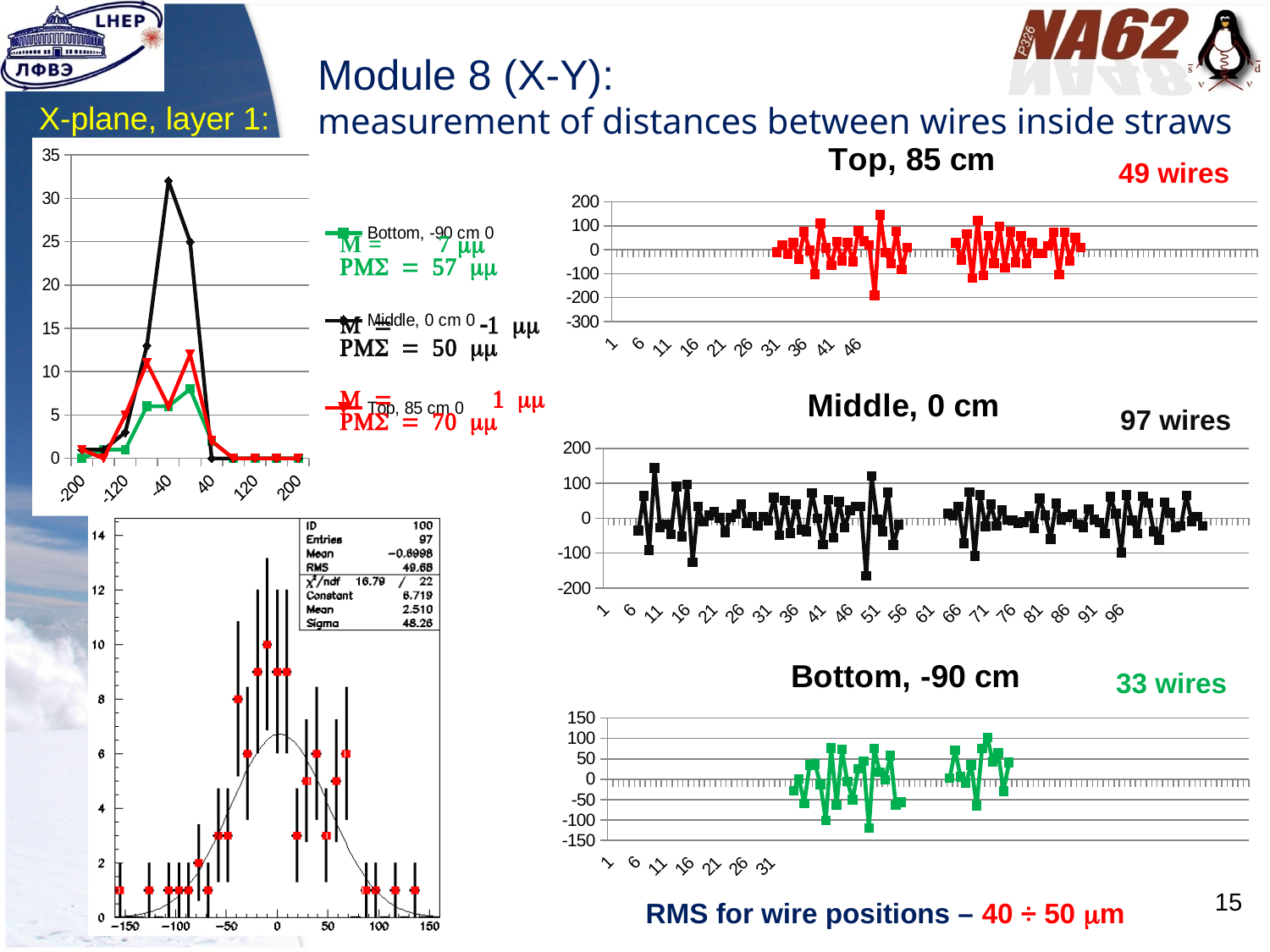
How many wires are plotted in the Middle, 0 cm chart? 97 In the Middle, 0 cm chart, is the highest plotted value greater or less than 100? greater What kind of chart is the top-left chart labelled X-plane, layer 1? line chart According to the text below the right-hand charts, what is the RMS for wire positions? 40 ÷ 50 μm In the Top, 85 cm chart, is the lowest plotted value greater or less than -100? less In the Bottom, -90 cm chart, is the highest plotted value greater or less than 50? greater What are the three legend entries of the top-left line chart (X-plane, layer 1)? Bottom, -90 cm 0; Middle, 0 cm 0; Top, 85 cm 0 How many series does the legend of the top-left line chart (X-plane, layer 1) list? 3 In the top-left line chart (X-plane, layer 1), which series reaches the highest peak? Middle, 0 cm How many wires are plotted in the Bottom, -90 cm chart? 33